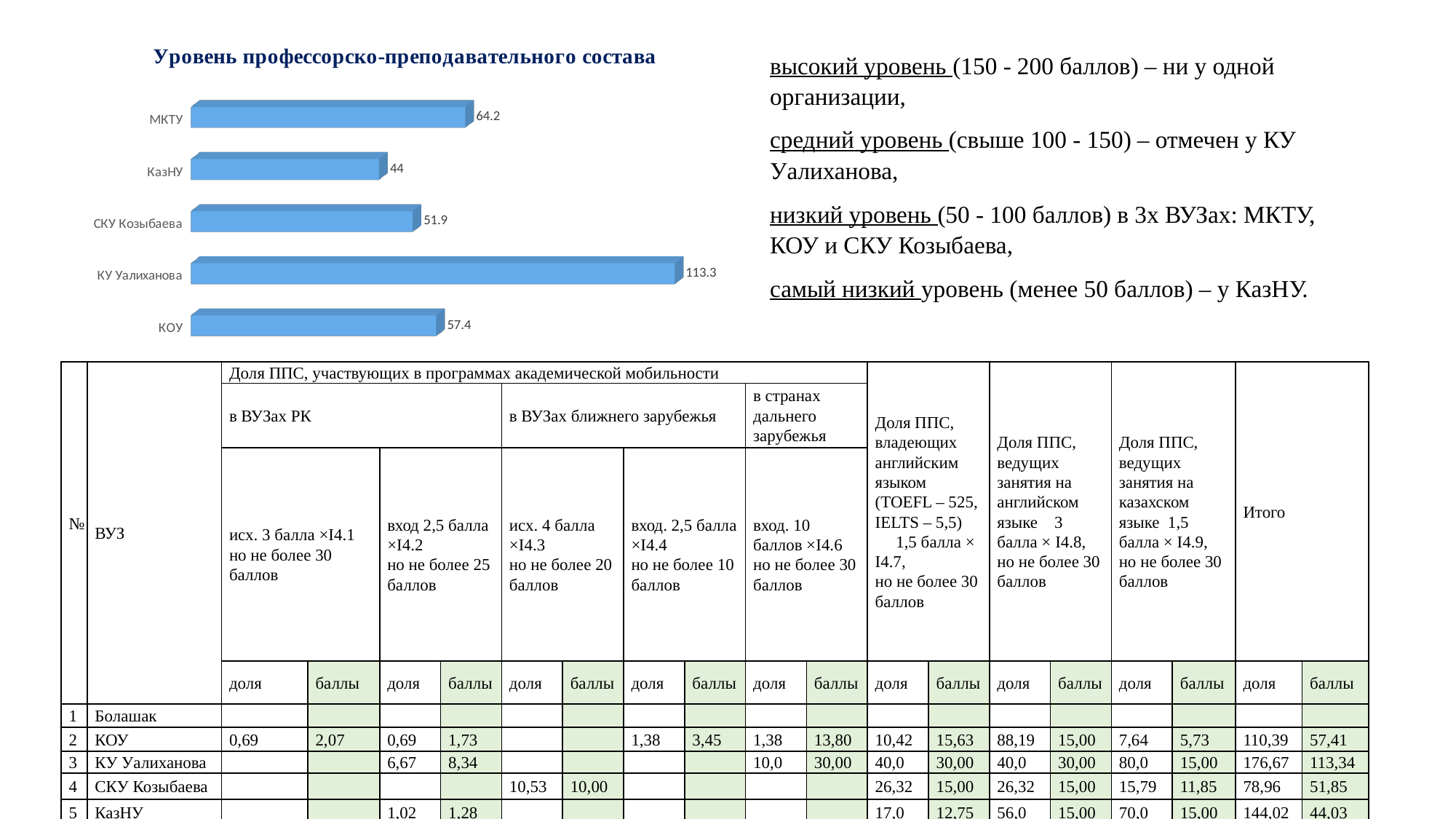
What is the value for КУ Уалиханова in the chart? 113.3 What is the value for КОУ in the chart? 57.4 What type of chart is shown on the slide? Bar chart Which is larger, the value for МКТУ or the value for КОУ? МКТУ What is the difference between the values for КОУ and КазНУ? 13.4 What is the value for КазНУ in the chart? 44 What is the value for МКТУ in the chart? 64.2 What is the difference between the values for КУ Уалиханова and МКТУ? 49.1 What is the value for СКУ Козыбаева in the chart? 51.9 Which university has the highest value in the chart? КУ Уалиханова How many universities are shown in the chart? 5 Which university has the lowest value in the chart? КазНУ